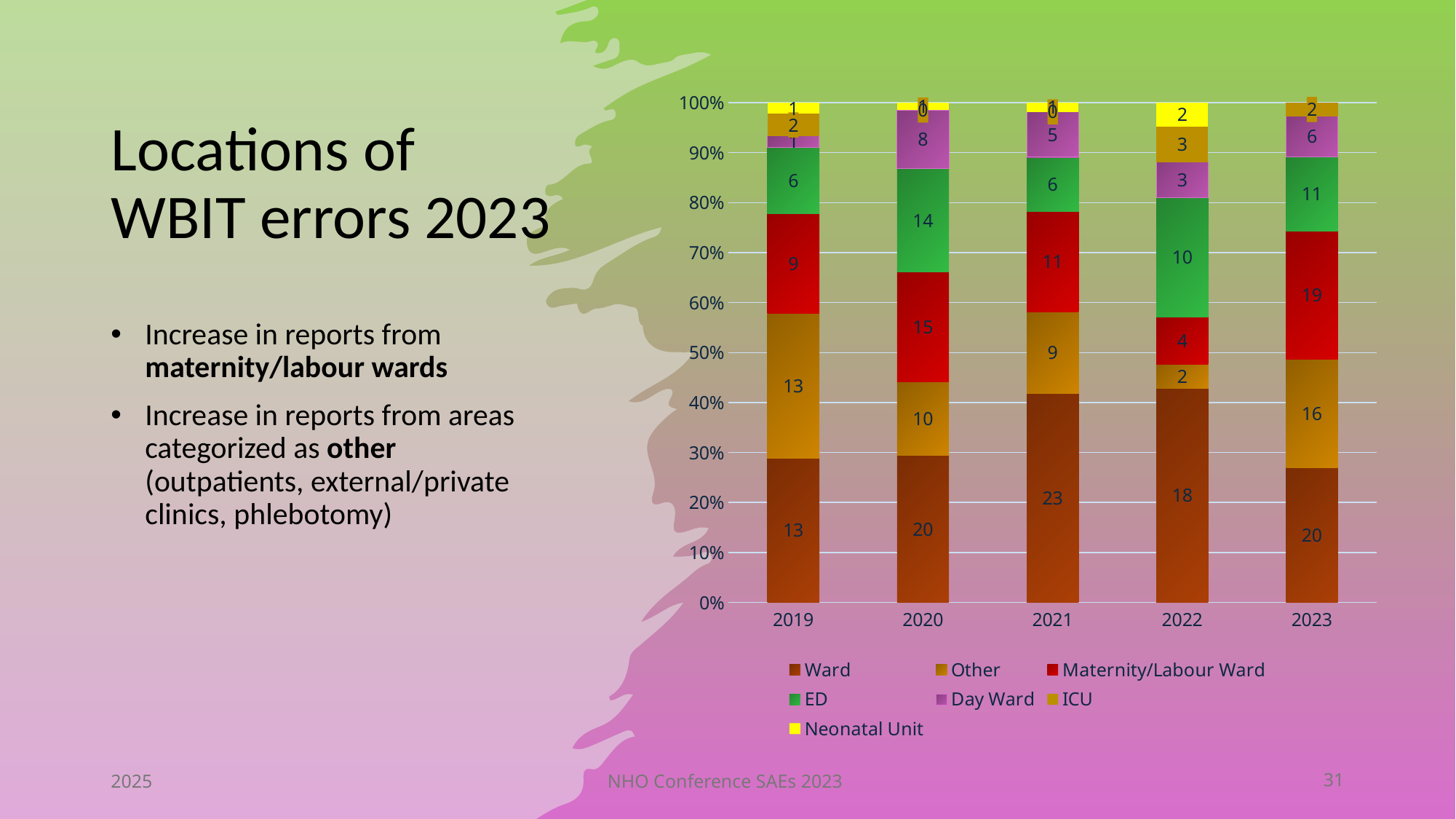
What kind of chart is shown on the slide? Stacked bar chart Which year has the larger ED value, 2020 or 2023? 2020 What is the difference between the Other value in 2023 and the Other value in 2022? 14 In which year is the Maternity/Labour Ward value highest? 2023 How many series does the chart legend list? 7 What is the total of all segments in the 2022 bar? 42 What is the value for Day Ward in 2020? 8 What is the value for Other in 2022? 2 What is the value for Maternity/Labour Ward in 2023? 19 How many years are shown on the x axis of the chart? 5 What colour represents Neonatal Unit in the chart legend? Yellow What is the value for Ward in 2021? 23